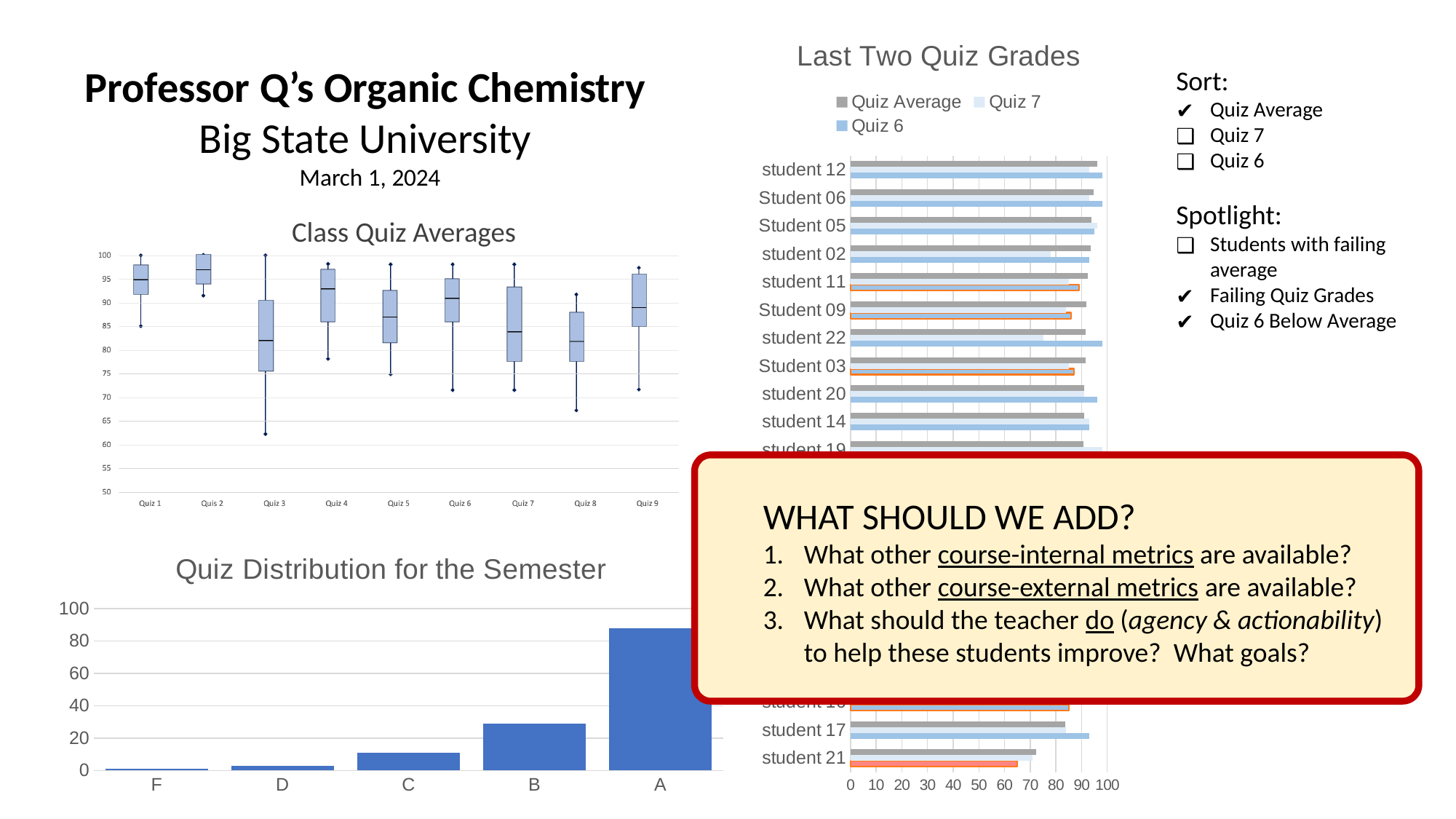
In "Quiz Distribution for the Semester", which is larger, the value for B or the value for C? B In "Quiz Distribution for the Semester", is the value for C greater or less than 20? less What are the legend entries of "Last Two Quiz Grades"? Quiz Average, Quiz 7, Quiz 6 In "Quiz Distribution for the Semester", do the values rise or fall moving from F to A along the x axis? rise In "Quiz Distribution for the Semester", is the value for A greater or less than 80? greater In "Quiz Distribution for the Semester", which grade category has the lowest value? F In "Quiz Distribution for the Semester", which grade category has the highest value? A How many grade categories are shown in "Quiz Distribution for the Semester"? 5 In "Last Two Quiz Grades", is the Quiz 6 value for student 21 greater or less than 70? less How many series does the legend of "Last Two Quiz Grades" list? 3 What kind of chart is "Quiz Distribution for the Semester"? bar chart How many quizzes are shown on the x axis of "Class Quiz Averages"? 9